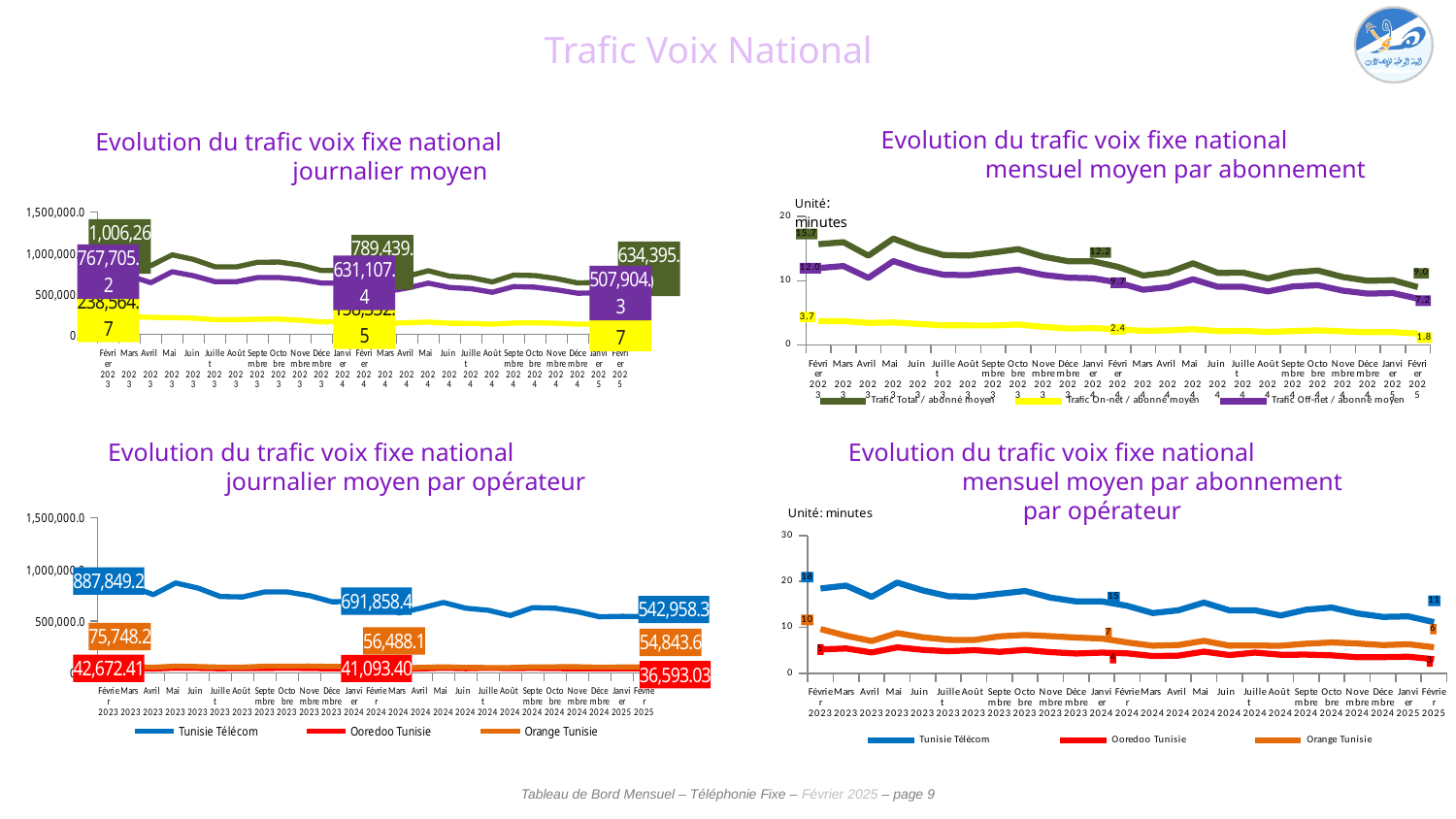
In the chart 'Evolution du trafic voix fixe national mensuel moyen par abonnement', what is the value of Trafic On-net / abonné moyen in Février 2025? 1.8 In the chart 'Evolution du trafic voix fixe national journalier moyen par opérateur', what is the value for Tunisie Télécom in Février 2023? 887,849.2 In the chart 'Evolution du trafic voix fixe national mensuel moyen par abonnement', what is the value of Trafic Total / abonné moyen in Février 2023? 15.7 In the chart 'Evolution du trafic voix fixe national mensuel moyen par abonnement par opérateur', what is the value for Tunisie Télécom in Février 2025? 11 In the chart 'Evolution du trafic voix fixe national journalier moyen par opérateur', is the value for Tunisie Télécom in Février 2025 greater or less than 1,000,000.0? less In the chart 'Evolution du trafic voix fixe national mensuel moyen par abonnement', how many series does the legend list? 3 What kind of chart is 'Evolution du trafic voix fixe national mensuel moyen par abonnement par opérateur'? line chart In the chart 'Evolution du trafic voix fixe national journalier moyen par opérateur', which operator has the highest values? Tunisie Télécom In the chart 'Evolution du trafic voix fixe national journalier moyen par opérateur', what is the value for Ooredoo Tunisie in Février 2025? 36,593.03 In the chart 'Evolution du trafic voix fixe national mensuel moyen par abonnement', does the Trafic Total / abonné moyen series rise or fall from Février 2023 to Février 2025? fall